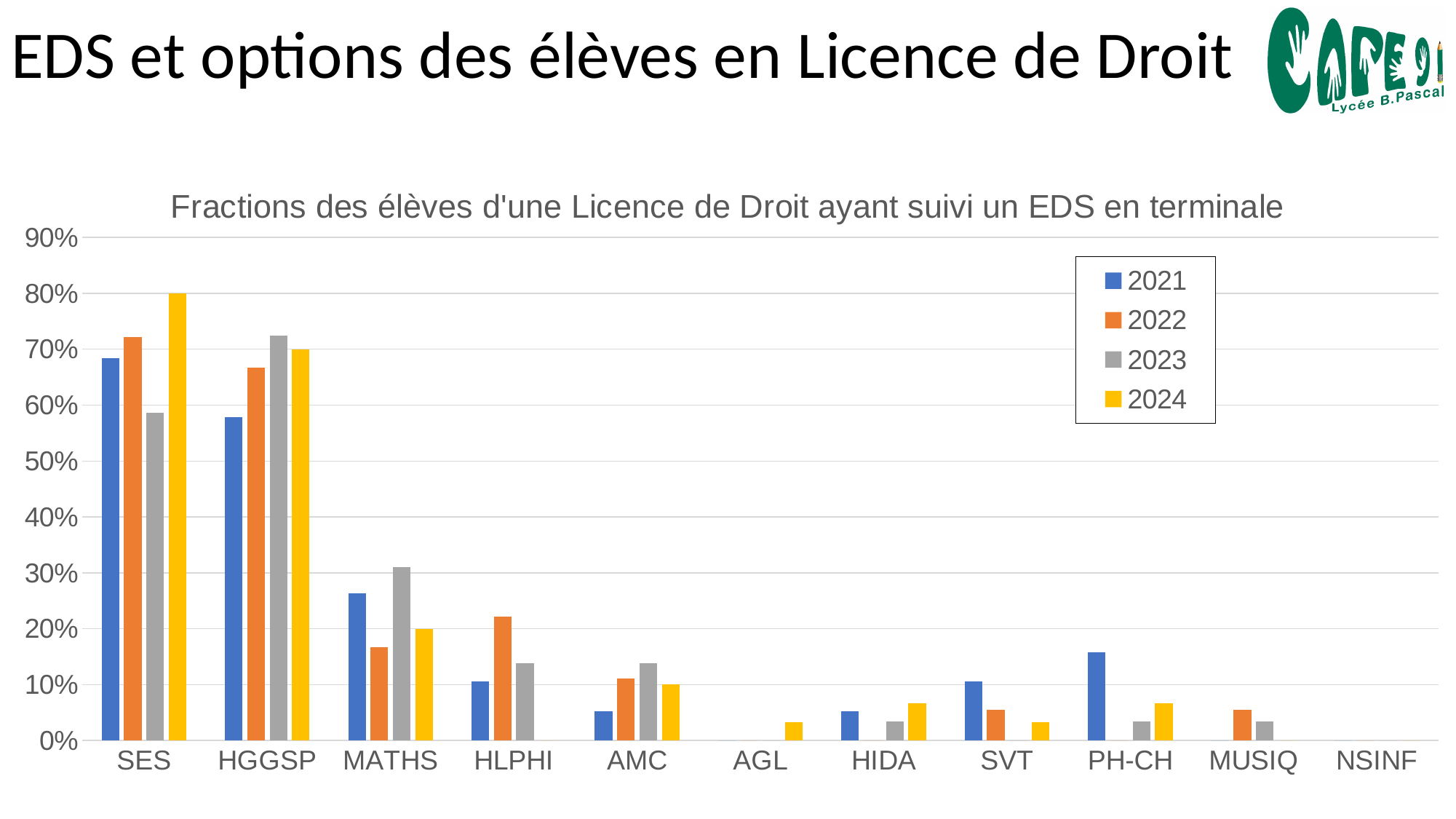
What is the title of the chart? Fractions des élèves d'une Licence de Droit ayant suivi un EDS en terminale For SES, which is larger: the 2022 value or the 2023 value? 2022 What is the value for HGGSP in 2024? 70% Is the value for HGGSP in 2021 greater or less than 60%? less Which category shows no bars at all? NSINF How many categories are shown on the x axis? 11 How many series does the legend list? 4 Is the value for MATHS in 2021 greater or less than 20%? greater Which category has the highest bar in the chart? SES Is the value for PH-CH in 2021 greater or less than 10%? greater What is the value for SES in 2024? 80% What type of chart is shown on the slide? bar chart